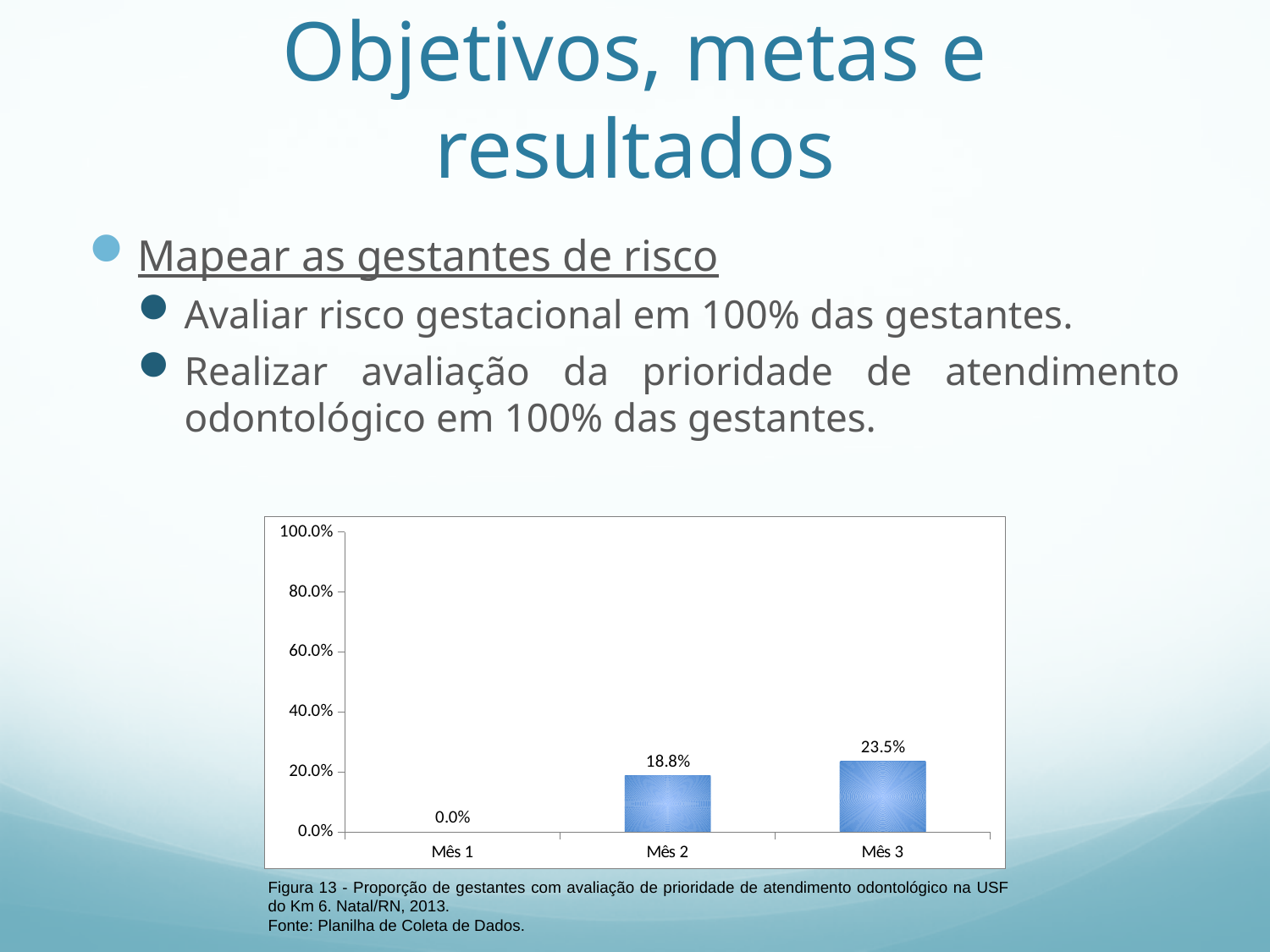
How many categories are shown on the x axis? 3 What kind of chart is shown on the slide? bar chart Which is larger, the value for Mês 2 or the value for Mês 3? Mês 3 Do the values rise or fall from Mês 1 to Mês 3? rise Which month has the highest value? Mês 3 What is the value for Mês 2? 18.8% What is the value for Mês 1? 0.0% Is the value for Mês 3 greater or less than 40.0%? less What is the value for Mês 3? 23.5% What is the highest value shown on the y axis? 100.0% Which month has the lowest value? Mês 1 What is the difference between the values for Mês 3 and Mês 2? 4.7%